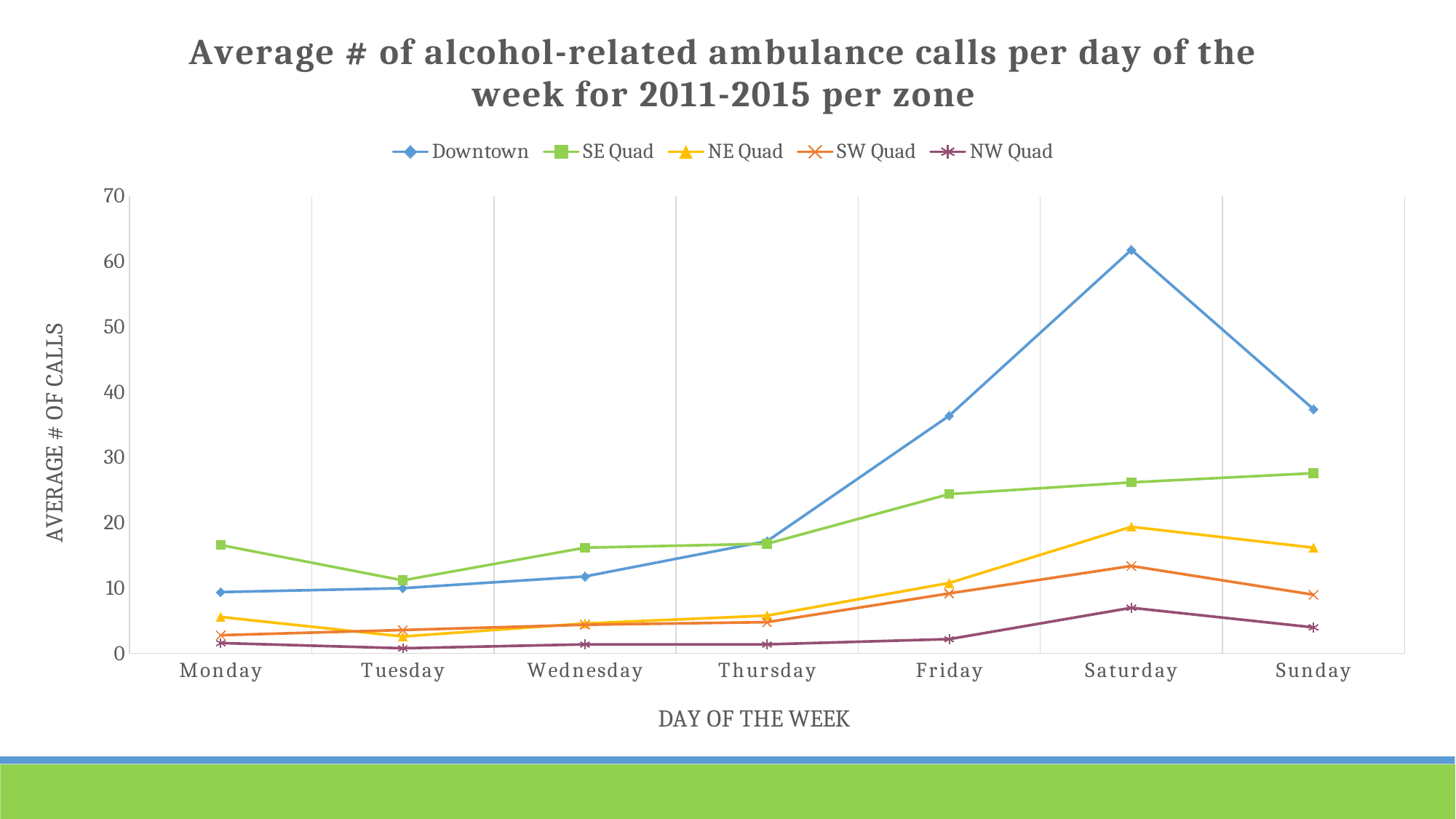
Is the Downtown value for Saturday greater or less than 60? greater Is the NE Quad value for Saturday greater or less than 15? greater What kind of chart is shown on the slide? line chart How many series does the legend list? 5 On Friday, which series has the larger value, Downtown or SE Quad? Downtown Does the Downtown series rise or fall from Thursday to Saturday? rise On Monday, which series has the larger value, SE Quad or Downtown? SE Quad Is the SE Quad value for Sunday greater or less than 30? less Which series has the lowest value on Saturday? NW Quad How many days of the week are plotted on the x axis? 7 On which day of the week does the Downtown series reach its highest value? Saturday